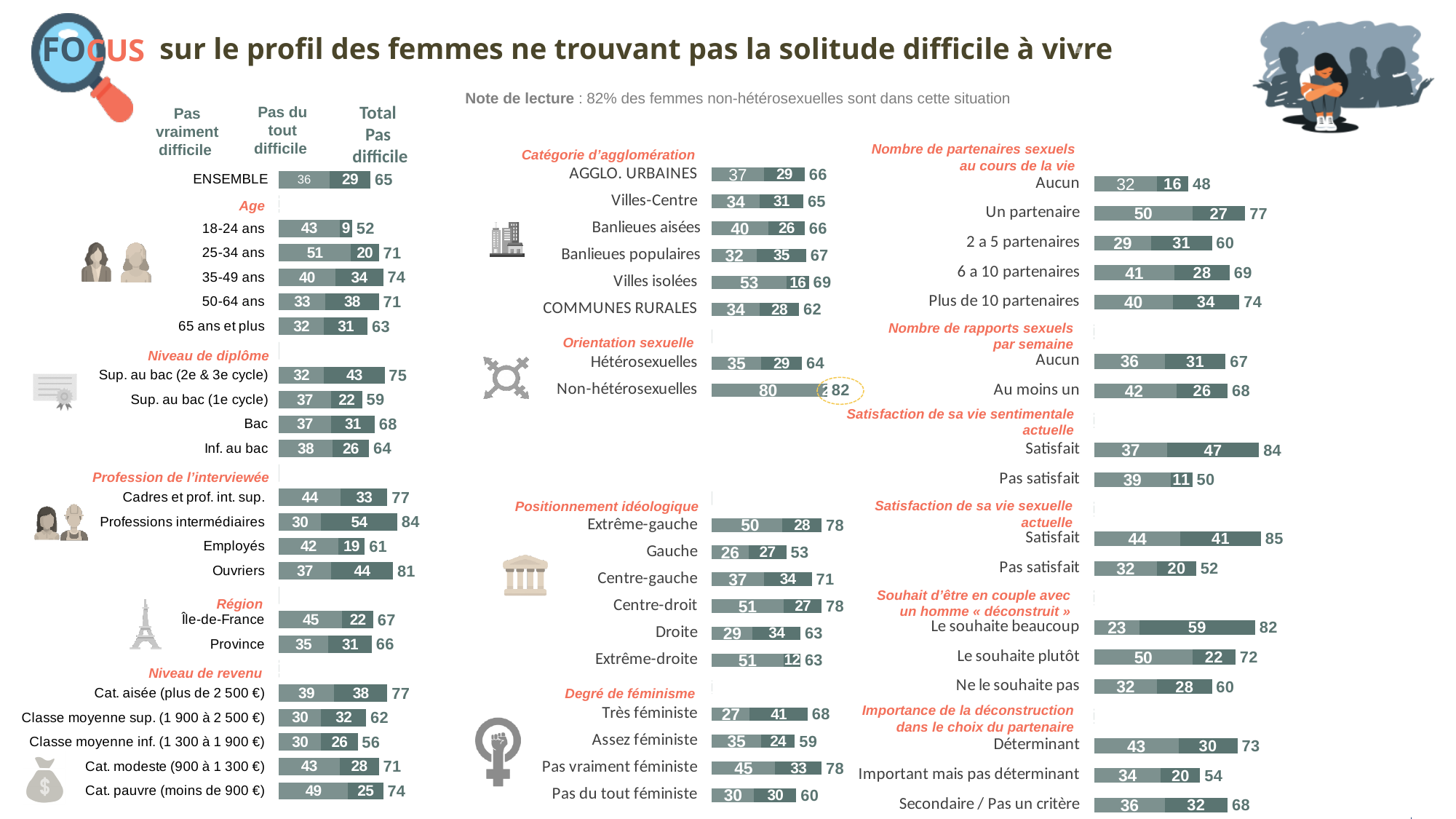
What kind of chart is used to show the 'Catégorie d'agglomération' data? Stacked bar chart In the 'Orientation sexuelle' chart, what is the 'Pas vraiment difficile' value for 'Non-hétérosexuelles'? 80 In the 'Positionnement idéologique' chart, what is the 'Pas du tout difficile' value for 'Extrême-droite'? 12 In the 'Profession de l'interviewée' chart, what is the 'Pas du tout difficile' value for 'Professions intermédiaires'? 54 In the 'Age' chart, what is the 'Total Pas difficile' value for '35-49 ans'? 74 In the 'Nombre de partenaires sexuels au cours de la vie' chart, what is the difference between the totals for 'Un partenaire' and 'Aucun'? 29 In the 'Age' chart, which age group has the lowest 'Total Pas difficile' value? 18-24 ans In the 'Positionnement idéologique' chart, how many categories are shown? 6 In the 'Satisfaction de sa vie sentimentale actuelle' chart, what is the total for 'Satisfait'? 84 In the 'Degré de féminisme' chart, which is larger: the total for 'Très féministe' or for 'Assez féministe'? Très féministe In the 'Nombre de partenaires sexuels au cours de la vie' chart, which category has the highest total? Un partenaire In the 'Niveau de revenu' chart, what is the total for 'Cat. pauvre (moins de 900 €)'? 74